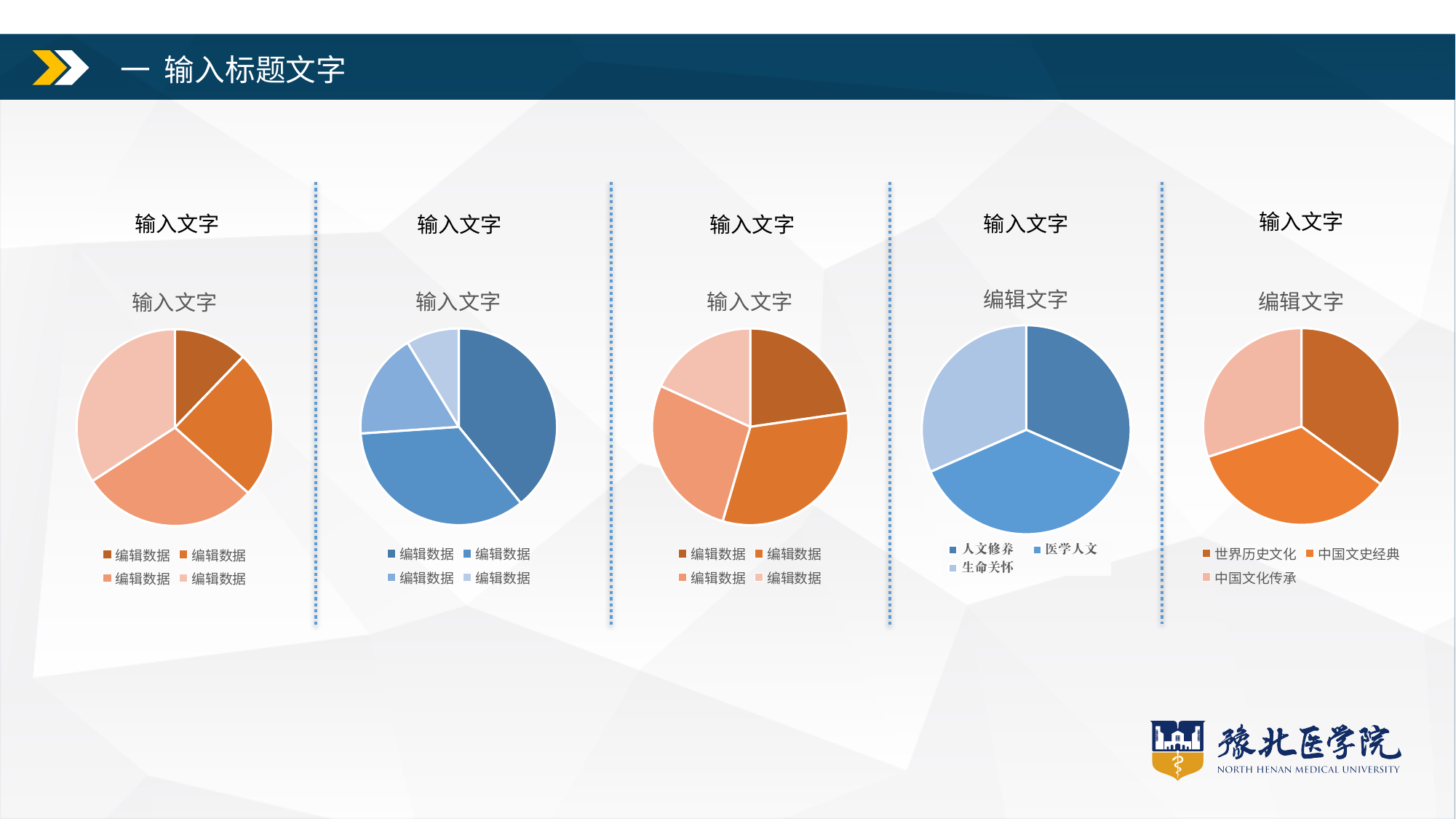
How many slices does the second pie chart from the left have? 4 How many slices does the rightmost pie chart have? 3 What kind of chart is the leftmost chart on the slide? Pie chart How many entries does the legend of the leftmost pie chart list? 4 In the leftmost pie chart, which slice is larger, the dark orange slice or the light pink slice? The light pink slice How many entries does the legend of the fourth pie chart from the left list? 3 How many slices does the leftmost pie chart have? 4 What are the legend entries of the rightmost pie chart? 世界历史文化, 中国文史经典, 中国文化传承 What are the legend entries of the fourth pie chart from the left? 人文修养, 医学人文, 生命关怀 In the second pie chart from the left, which slice is larger, the dark blue slice or the lightest blue slice? The dark blue slice